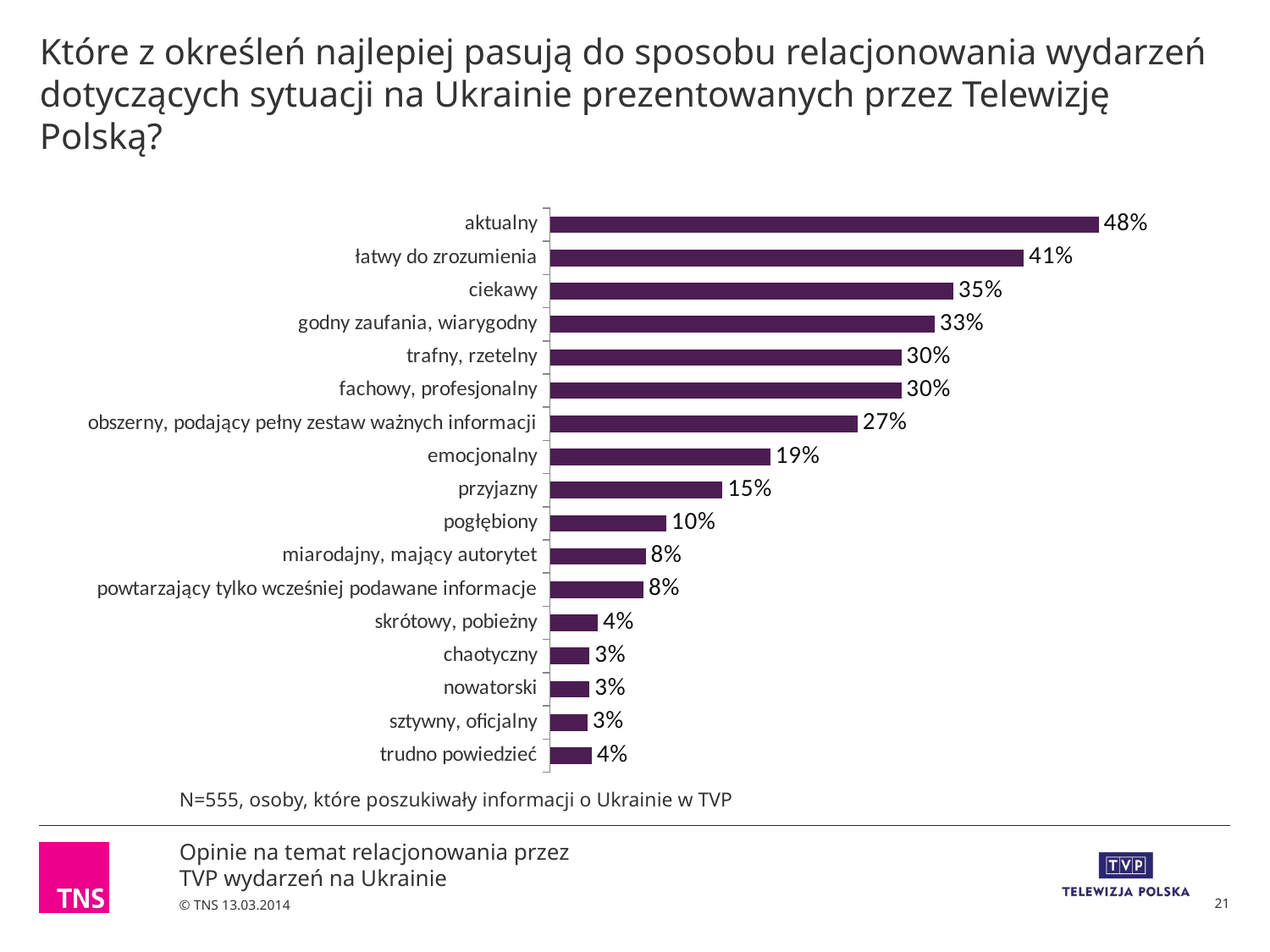
What is the value for "łatwy do zrozumienia"? 41% What kind of chart is shown on the slide? bar chart What is the difference between the values for "aktualny" and "łatwy do zrozumienia"? 7% What sample size is stated below the chart? N=555 What is the value for "aktualny"? 48% How many categories are shown in the chart? 17 What is the value for "emocjonalny"? 19% What is the value for "pogłębiony"? 10% What is the difference between the values for "ciekawy" and "przyjazny"? 20% Which category has the highest value? aktualny Which is larger, the value for "godny zaufania, wiarygodny" or the value for "obszerny, podający pełny zestaw ważnych informacji"? godny zaufania, wiarygodny What is the value for "trudno powiedzieć"? 4%